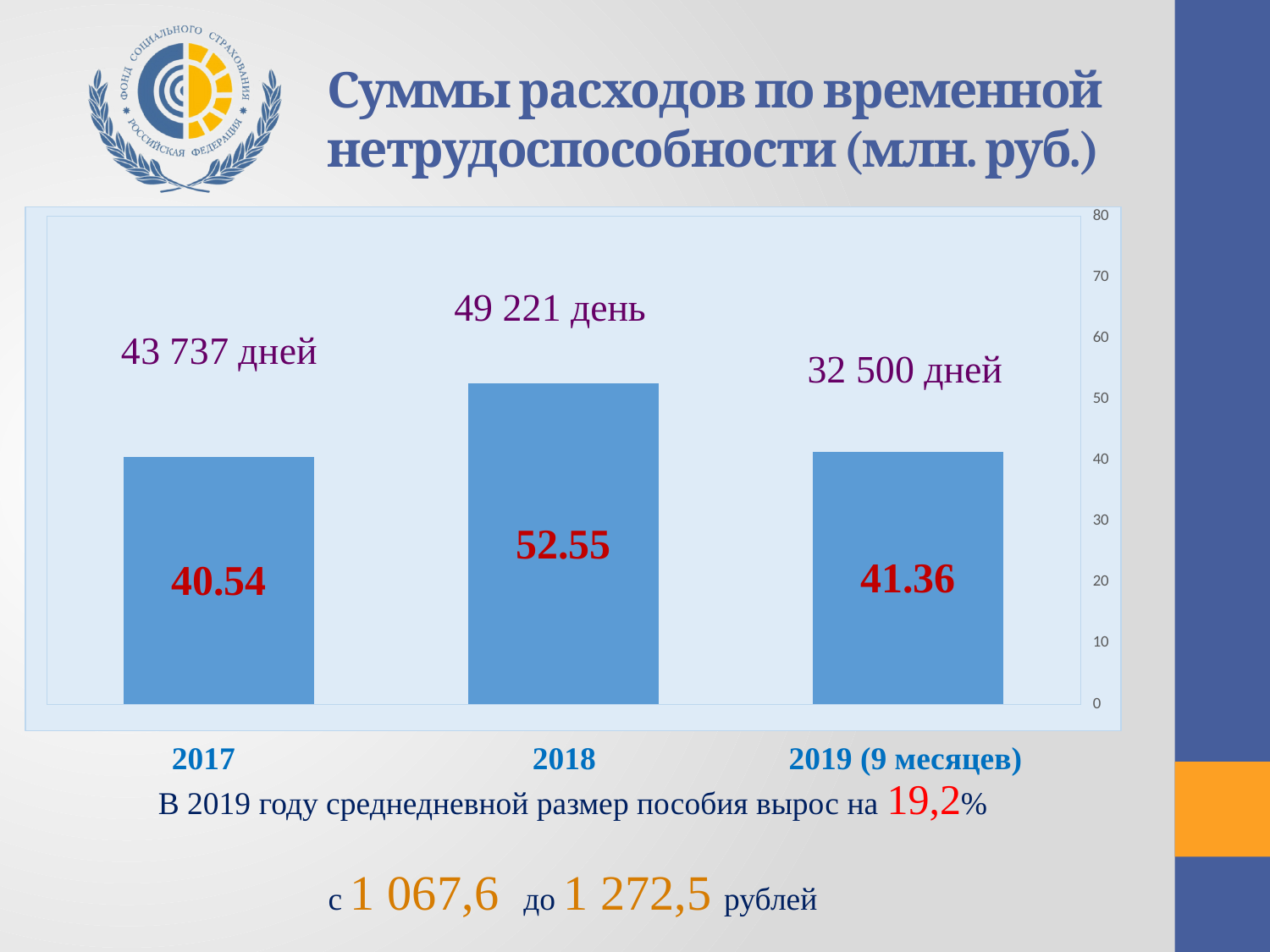
What kind of chart is shown on the slide? bar chart Which category has the lowest value? 2017 Which is larger, the value for 2018 or the value for 2019 (9 месяцев)? 2018 What is the value for 2018? 52.55 How many bars are shown in the chart? 3 What is the difference between the values for 2018 and 2017? 12.01 How many days are labelled above the 2018 bar? 49 221 день Is the value for 2018 greater or less than 50? greater What is the value for 2017? 40.54 What is the value for 2019 (9 месяцев)? 41.36 Which category has the highest value? 2018 What is the title of the chart? Суммы расходов по временной нетрудоспособности (млн. руб.)